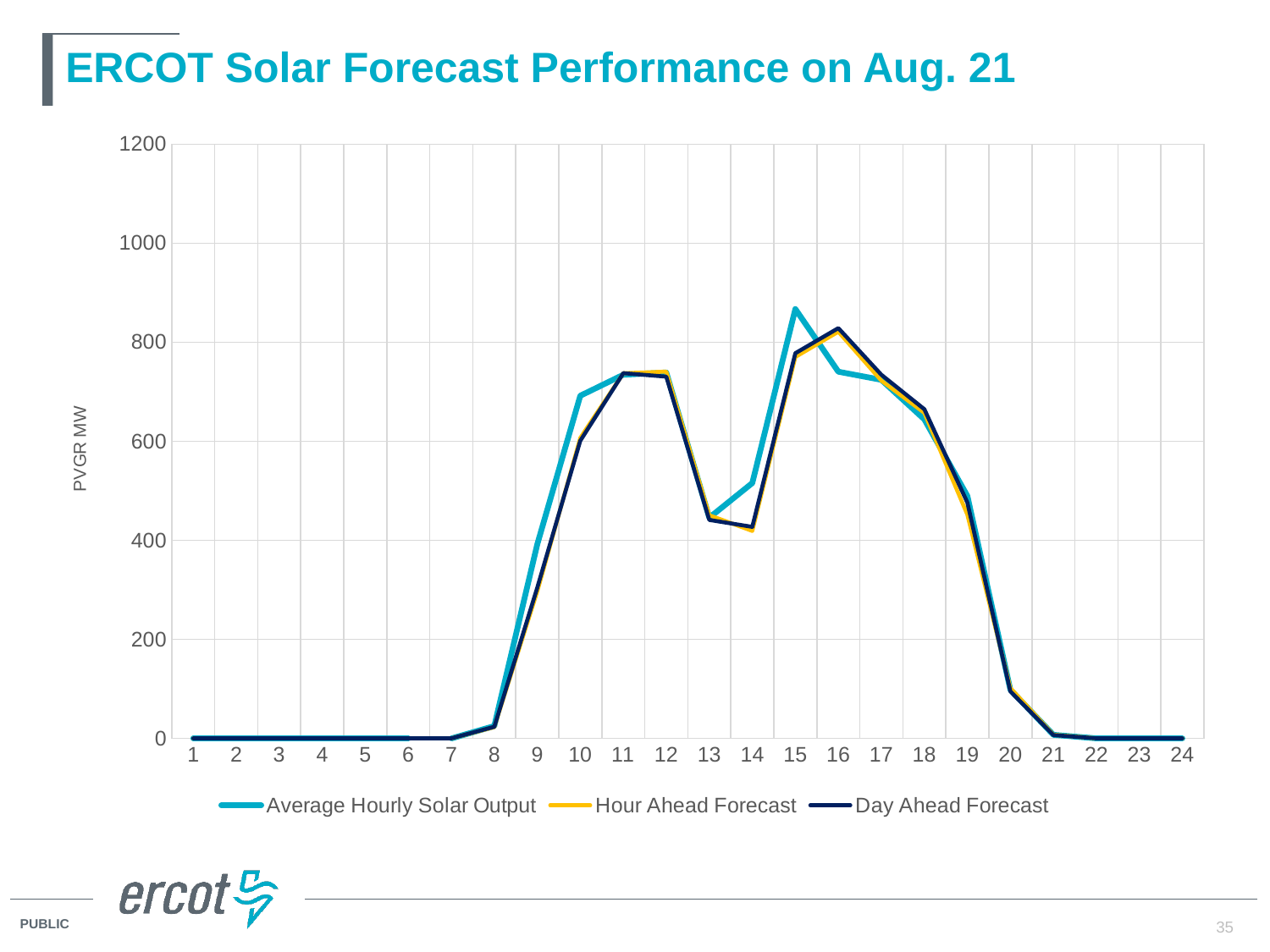
Is the Day Ahead Forecast at hour 13 greater or less than 600? less What is the label on the y axis? PVGR MW At which hour does the Day Ahead Forecast reach its highest value? 16 How many hours are plotted along the x axis? 24 Does the Average Hourly Solar Output rise or fall from hour 16 to hour 21? fall Is the Average Hourly Solar Output at hour 20 greater or less than 200? less What kind of chart is shown on the slide? line chart At hour 15, which is higher: the Average Hourly Solar Output or the Day Ahead Forecast? Average Hourly Solar Output At hour 10, which is higher: the Average Hourly Solar Output or the Day Ahead Forecast? Average Hourly Solar Output Is the Average Hourly Solar Output at hour 15 greater or less than 800? greater At which hour does the Average Hourly Solar Output reach its highest value? 15 How many series does the legend list? 3